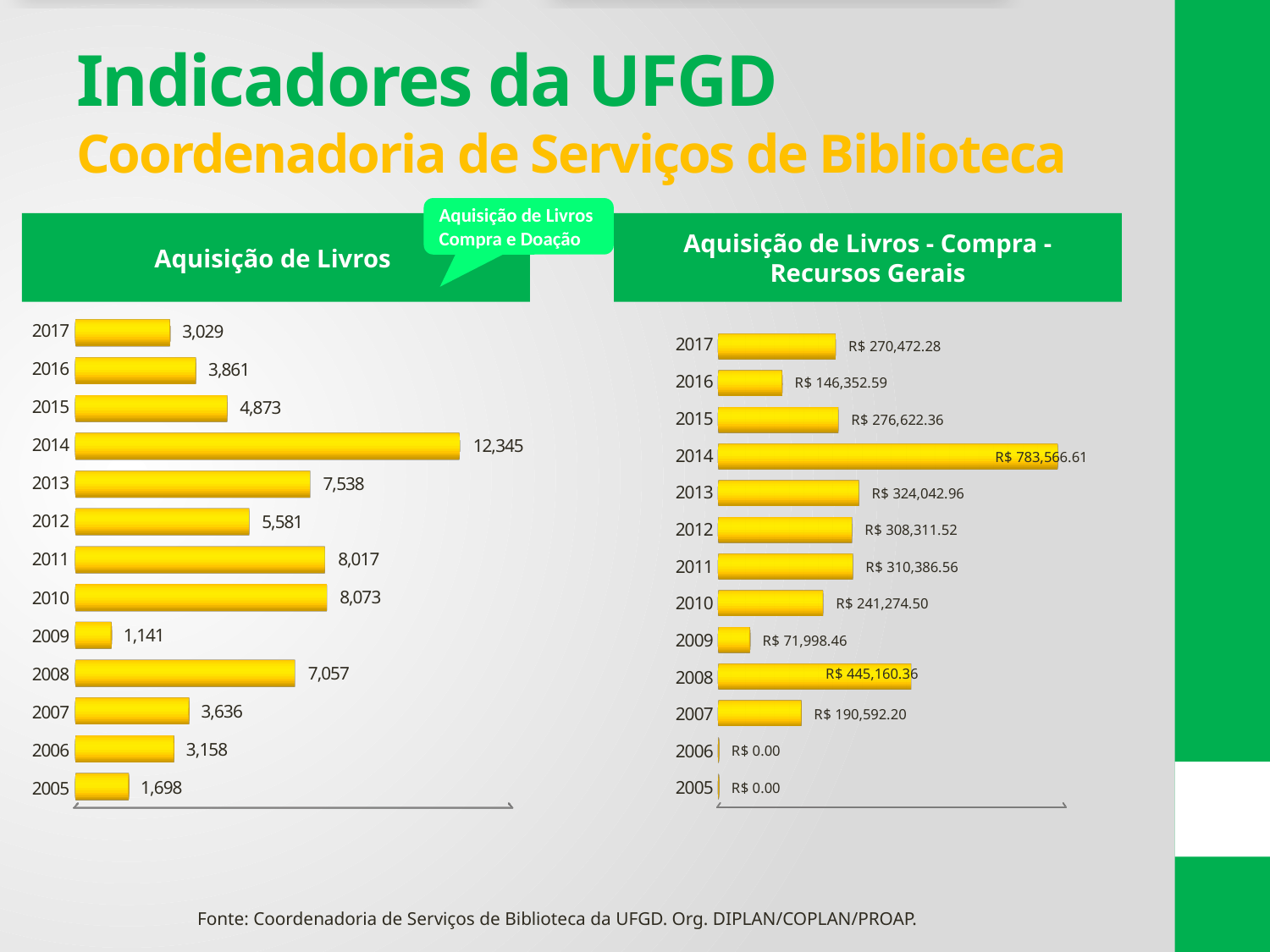
In the 'Aquisição de Livros' chart, what is the difference between the values for 2014 and 2013? 4,807 In the 'Aquisição de Livros - Compra - Recursos Gerais' chart, what is the value for 2006? R$ 0.00 How many years are shown in the 'Aquisição de Livros' chart? 13 In the 'Aquisição de Livros - Compra - Recursos Gerais' chart, what is the difference between the values for 2017 and 2016? R$ 124,119.69 What type of chart is 'Aquisição de Livros - Compra - Recursos Gerais'? Bar chart In the 'Aquisição de Livros' chart, what is the value for 2009? 1,141 In the 'Aquisição de Livros - Compra - Recursos Gerais' chart, what is the value for 2013? R$ 324,042.96 In the 'Aquisição de Livros' chart, which year has the highest value? 2014 In the 'Aquisição de Livros - Compra - Recursos Gerais' chart, which year has the highest value? 2014 In the 'Aquisição de Livros' chart, which year has the larger value, 2008 or 2012? 2008 In the 'Aquisição de Livros' chart, which year has the lowest value? 2009 In the 'Aquisição de Livros' chart, what is the value for 2014? 12,345